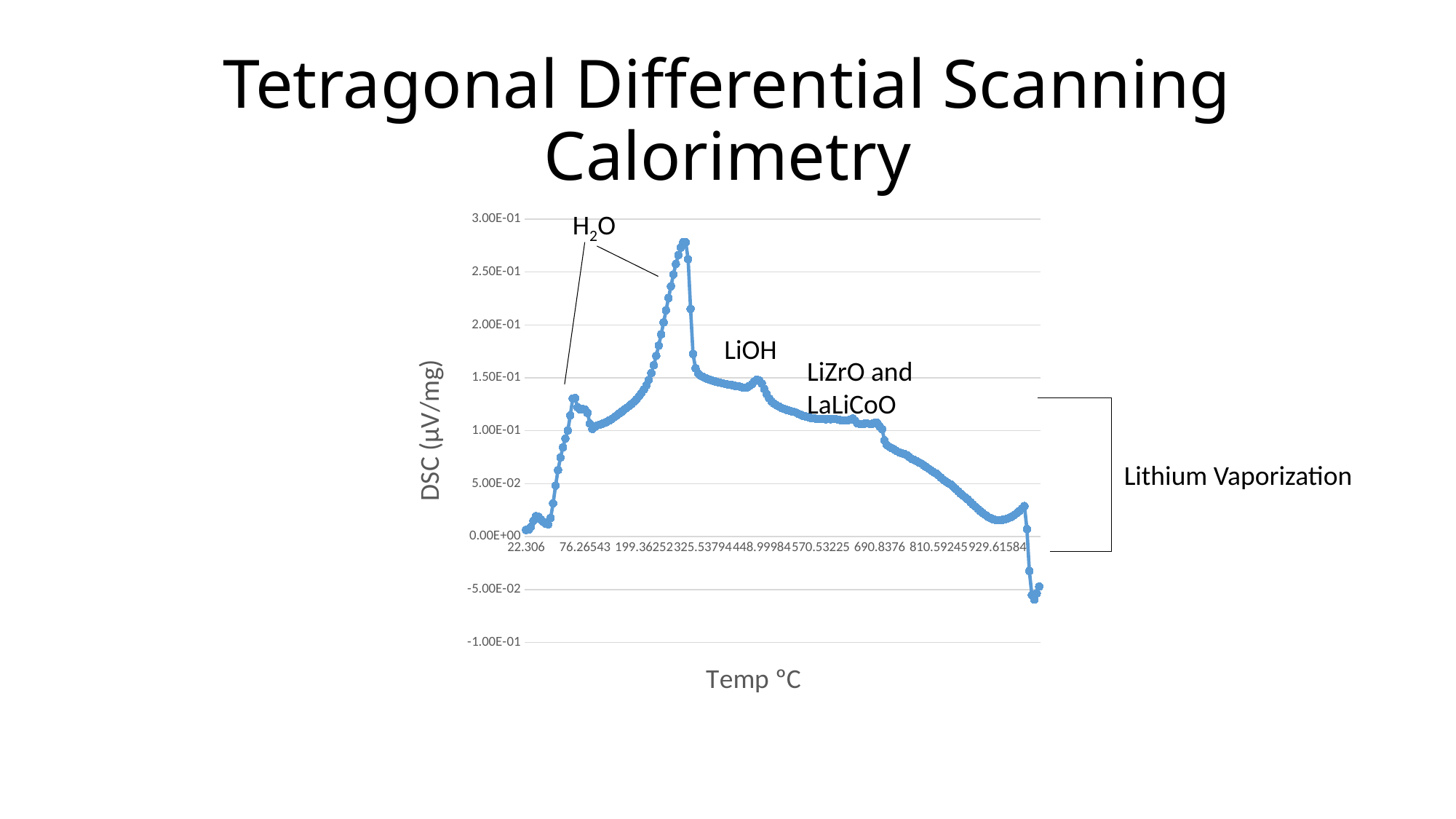
What is the label on the vertical axis of the chart? DSC (µV/mg) Between the x-axis ticks 570.53225 and 929.61584, does the DSC curve generally rise or fall? fall What kind of chart is shown on the slide? line chart Which process is annotated with a bracket at the right end of the curve? Lithium Vaporization Is the lowest DSC value on the curve, at the far right, greater or less than 0.00E+00? less Is the highest peak of the DSC curve greater or less than 2.50E-01? greater Is the DSC value at the peak labelled LiOH greater or less than 2.00E-01? less What is the title of the slide's chart? Tetragonal Differential Scanning Calorimetry